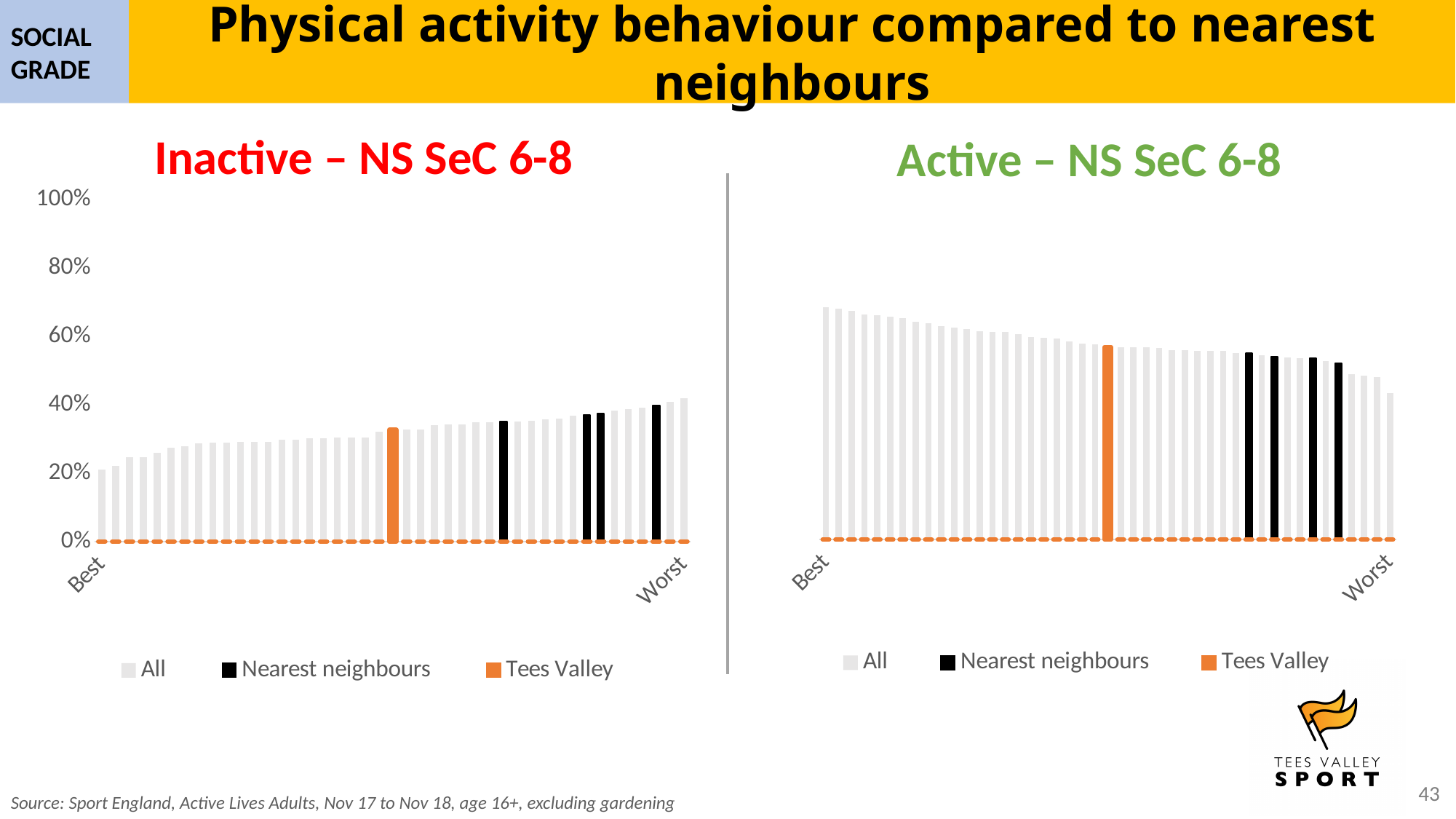
In the 'Inactive – NS SeC 6-8' chart, is the value for Tees Valley greater or less than 40%? less How many 'Nearest neighbours' bars are shown in the 'Inactive – NS SeC 6-8' chart? 4 In the 'Inactive – NS SeC 6-8' chart, do the values rise or fall from Best to Worst? rise In the 'Active – NS SeC 6-8' chart, is the value for Tees Valley greater or less than 40%? greater What colour represents Tees Valley in the legend of the 'Inactive – NS SeC 6-8' chart? orange In the 'Active – NS SeC 6-8' chart, is the value for Tees Valley greater or less than 60%? less Is the Tees Valley value larger in the 'Active – NS SeC 6-8' chart or the 'Inactive – NS SeC 6-8' chart? Active – NS SeC 6-8 What kind of chart is the 'Inactive – NS SeC 6-8' chart? bar chart How many series does the legend of the 'Active – NS SeC 6-8' chart list? 3 In the 'Active – NS SeC 6-8' chart, do the values rise or fall from Best to Worst? fall In the 'Active – NS SeC 6-8' chart, which is larger: the Tees Valley bar or the first bar at the Best end? the first bar at the Best end